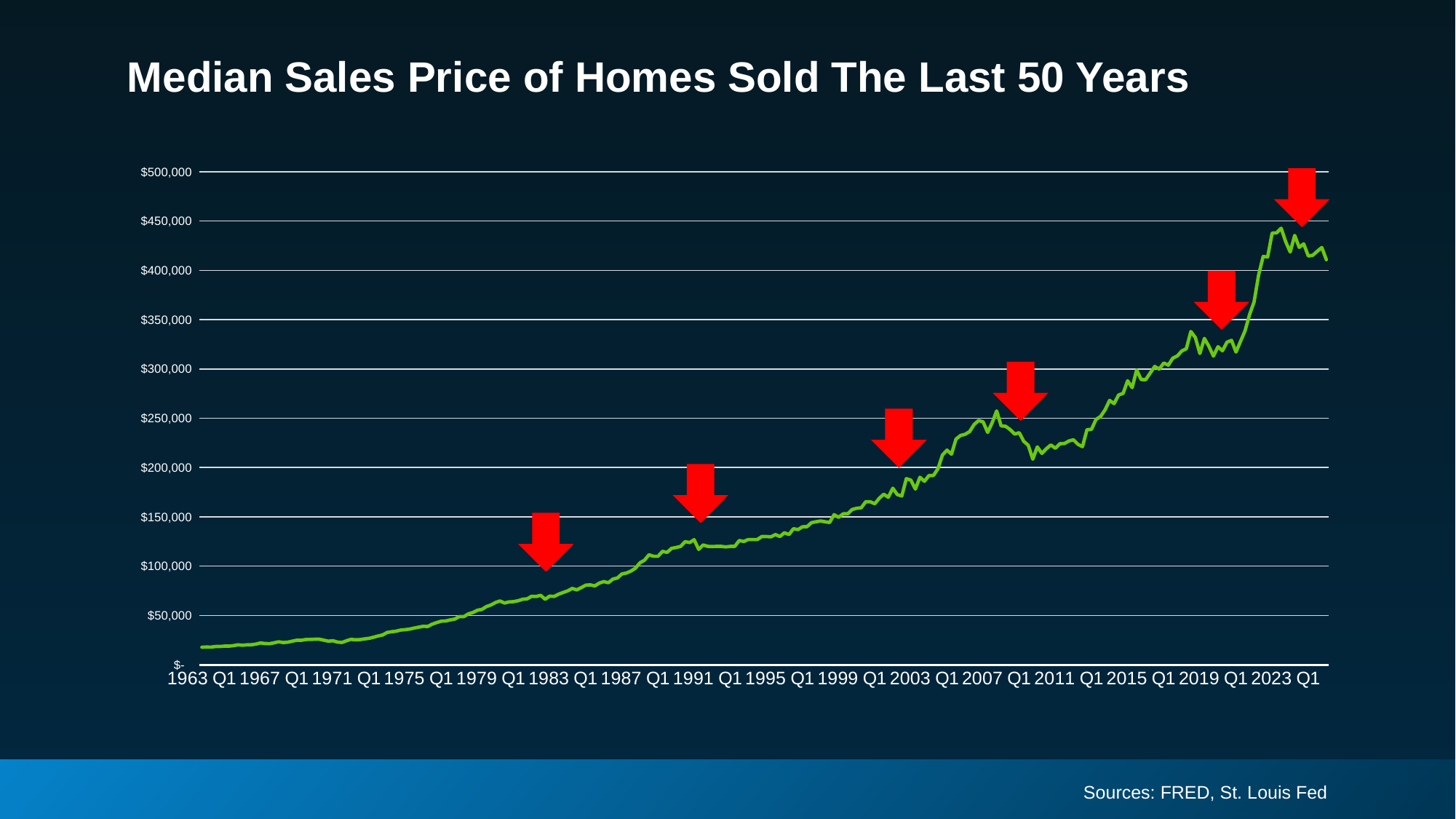
Is the value for 2007 Q1 greater or less than $200,000? greater Is the value for 1991 Q1 greater or less than $150,000? less How many year labels are shown along the x axis? 16 Is the value for 2019 Q1 greater or less than $300,000? greater What kind of chart is shown on the slide? line chart How many red arrows are placed on the chart? 6 What is the title of the chart? Median Sales Price of Homes Sold The Last 50 Years Overall, do the values rise or fall from 1963 Q1 to 2023 Q1? rise